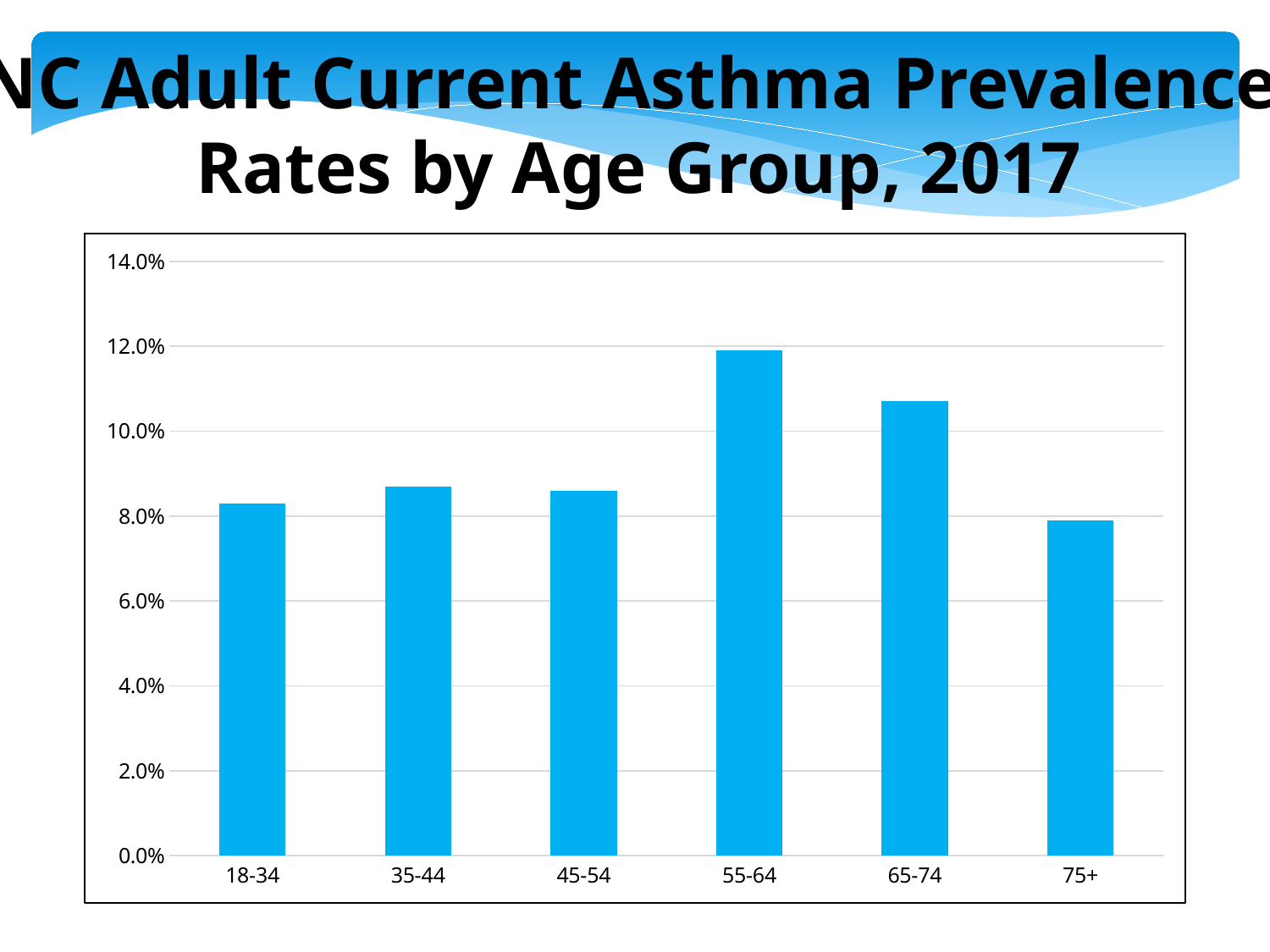
What kind of chart is shown on the slide? Bar chart Which has a higher asthma prevalence rate, the 65-74 age group or the 75+ age group? 65-74 Which has a higher asthma prevalence rate, the 55-64 age group or the 65-74 age group? 55-64 How many age groups are shown on the chart? 6 Is the value for the 18-34 age group greater or less than 8.0%? greater Is the value for the 55-64 age group greater or less than 10.0%? greater Which age group has the highest asthma prevalence rate? 55-64 Is the value for the 65-74 age group greater or less than 10.0%? greater Which age group has the lowest asthma prevalence rate? 75+